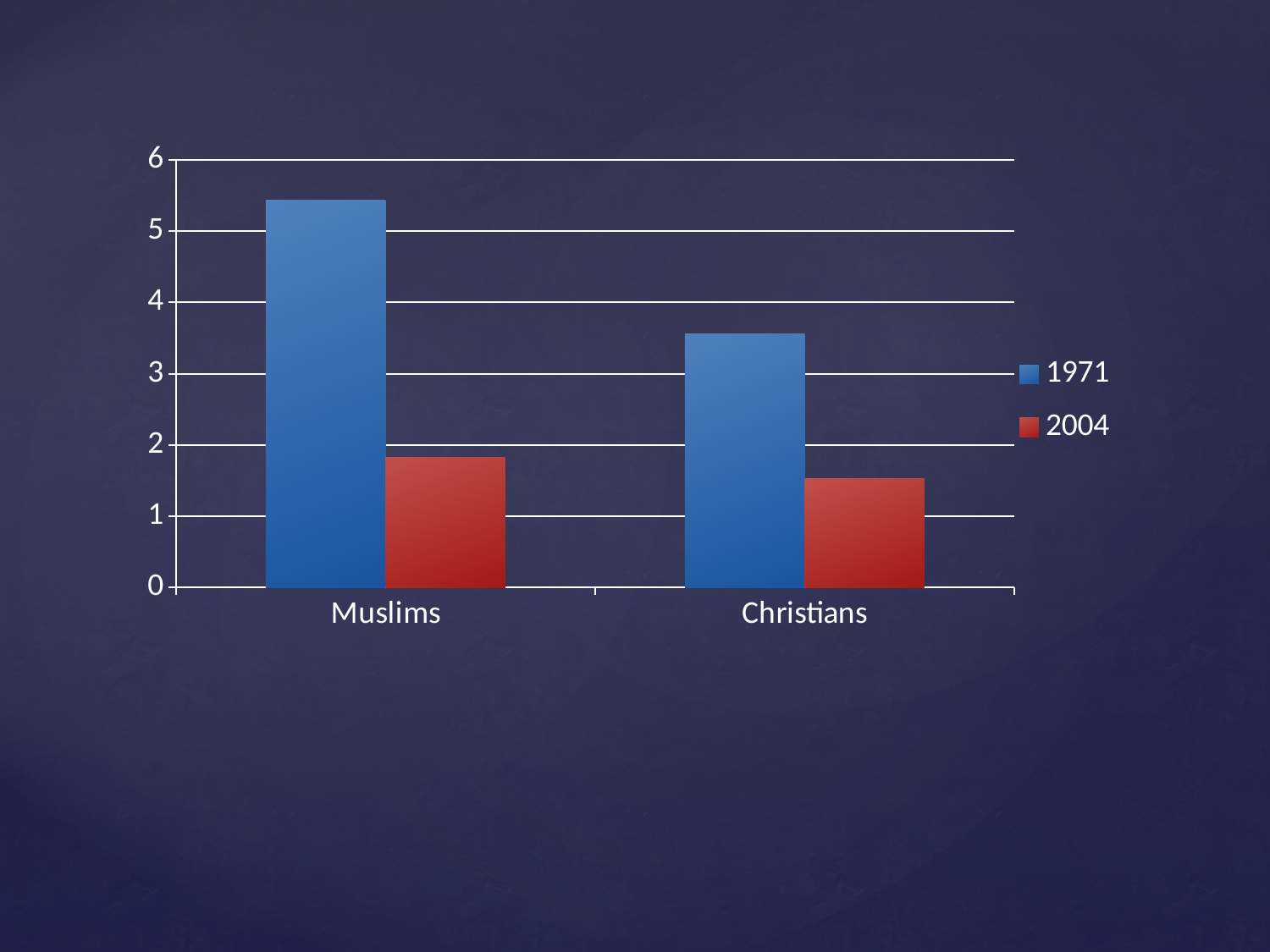
What are the two entries listed in the legend? 1971 and 2004 Which category has the highest value for the 1971 series? Muslims Is the 2004 value for Muslims greater or less than 2? less Is the 1971 value for Muslims greater or less than 5? greater Is the 2004 value for Christians greater or less than 2? less What kind of chart is shown on the slide? bar chart Which series is shown in red? 2004 For Christians, which series has the larger value, 1971 or 2004? 1971 How many categories are shown on the x axis? 2 How many series does the legend list? 2 Which category has the lowest value for the 2004 series? Christians